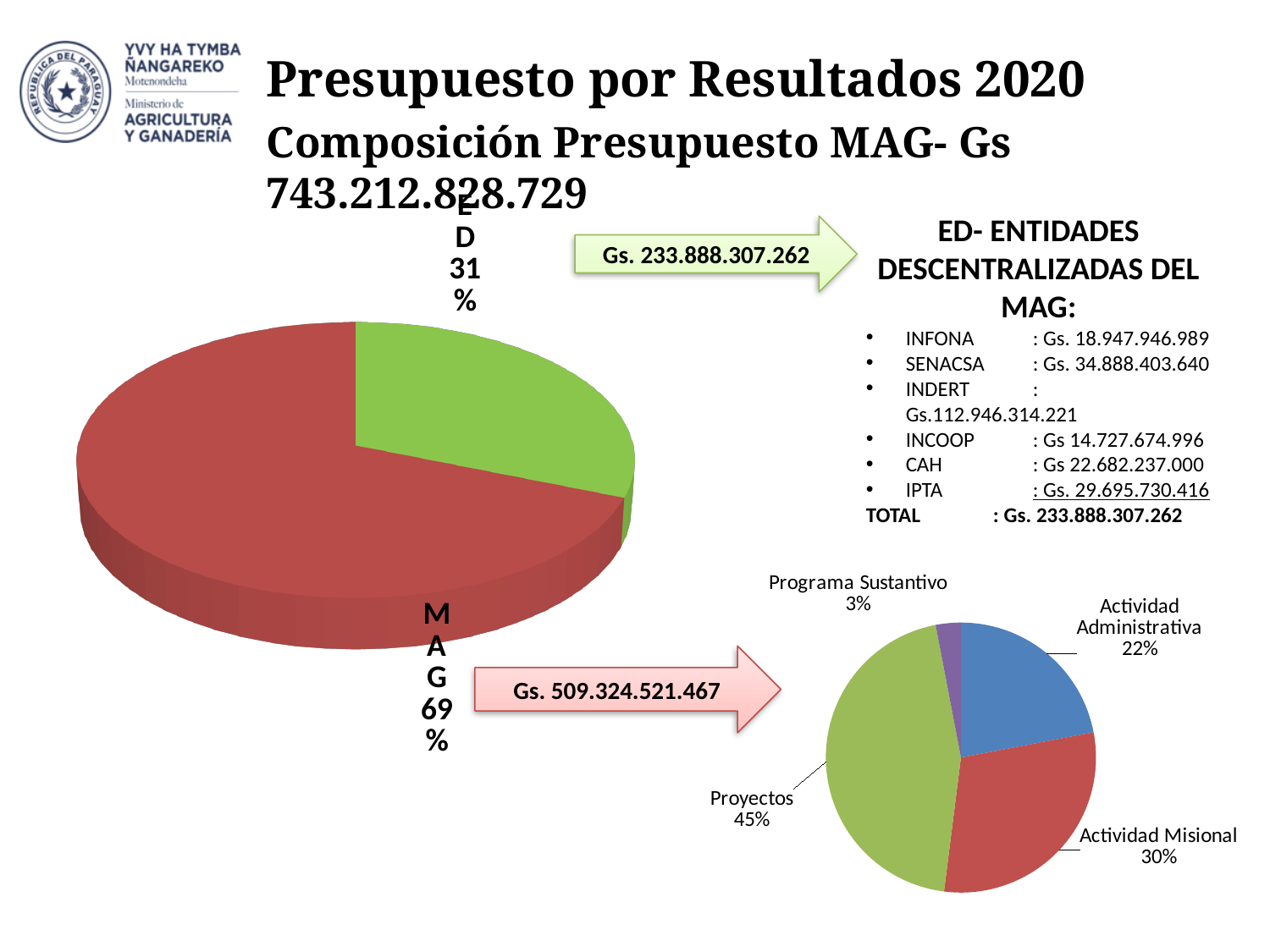
In the large pie chart on the left, which slice is larger, MAG or ED? MAG In the small pie chart at the bottom right, which category has the largest share? Proyectos In the small pie chart at the bottom right, what share does Proyectos have? 45% What kind of chart is the large chart on the left of the slide? Pie chart In the small pie chart at the bottom right, what share does Programa Sustantivo have? 3% In the large pie chart on the left, what share does ED have? 31% In the large pie chart on the left, how many slices are there? 2 In the small pie chart at the bottom right, how many categories are shown? 4 In the small pie chart at the bottom right, which category has the smallest share? Programa Sustantivo In the small pie chart at the bottom right, what is the difference in percentage points between Actividad Misional and Actividad Administrativa? 8 percentage points